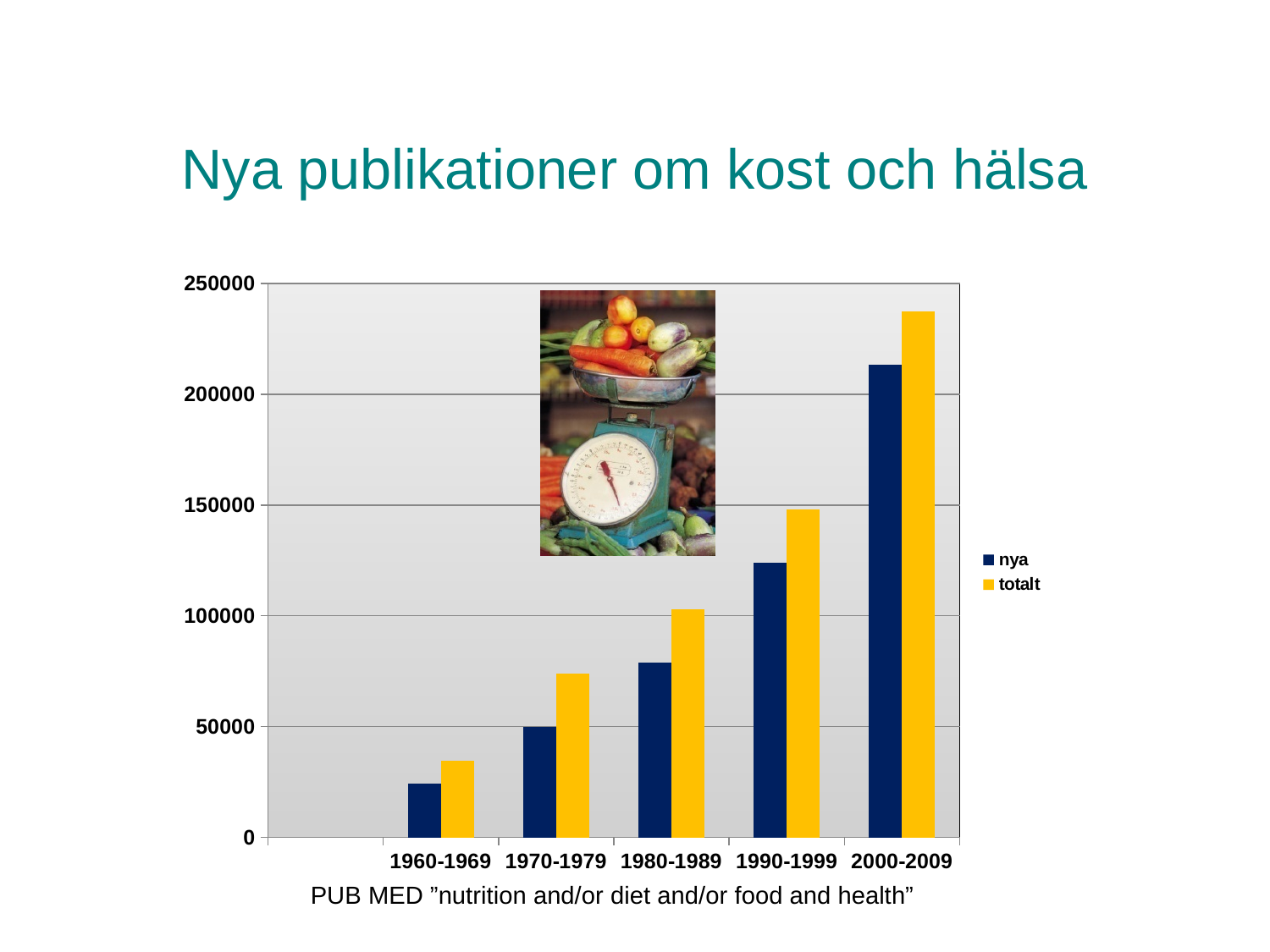
How many series does the legend list? 2 Is the value for nya in 1960-1969 greater or less than 50000? less Which is larger in 1990-1999, nya or totalt? totalt Which decade has the lowest value for nya? 1960-1969 Which decade has the highest value for totalt? 2000-2009 What kind of chart is shown on the slide? bar chart Is the value for nya in 2000-2009 greater or less than 200000? greater What is the title of the chart on the slide? Nya publikationer om kost och hälsa Is the value for totalt in 1980-1989 greater or less than 100000? greater How many decade categories are shown on the x axis? 5 Do the values for nya rise or fall from 1960-1969 to 2000-2009? rise